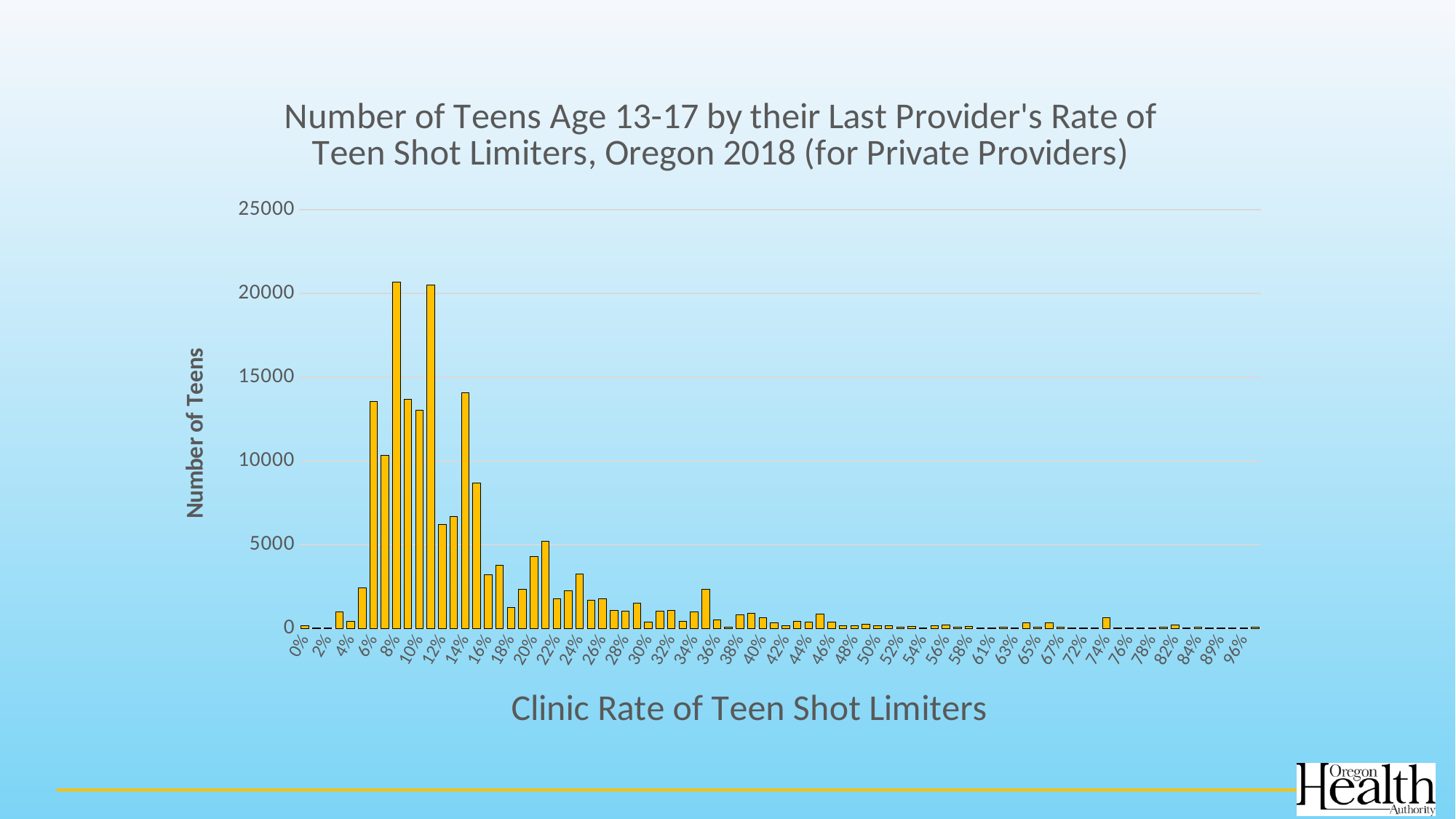
Is the value for 6% greater or less than 10000? greater Which has a larger value, 6% or 40%? 6% Is the tallest bar in the chart greater or less than 20000? greater Is the value for 2% greater or less than 5000? less Do the values generally rise or fall along the x axis from 20% to 96%? fall Which has a larger value, 0% or 8%? 8% What is the title of the chart? Number of Teens Age 13-17 by their Last Provider's Rate of Teen Shot Limiters, Oregon 2018 (for Private Providers) How many data series does the chart plot? 1 What kind of chart is shown on the slide? Bar chart What is the label of the x axis? Clinic Rate of Teen Shot Limiters